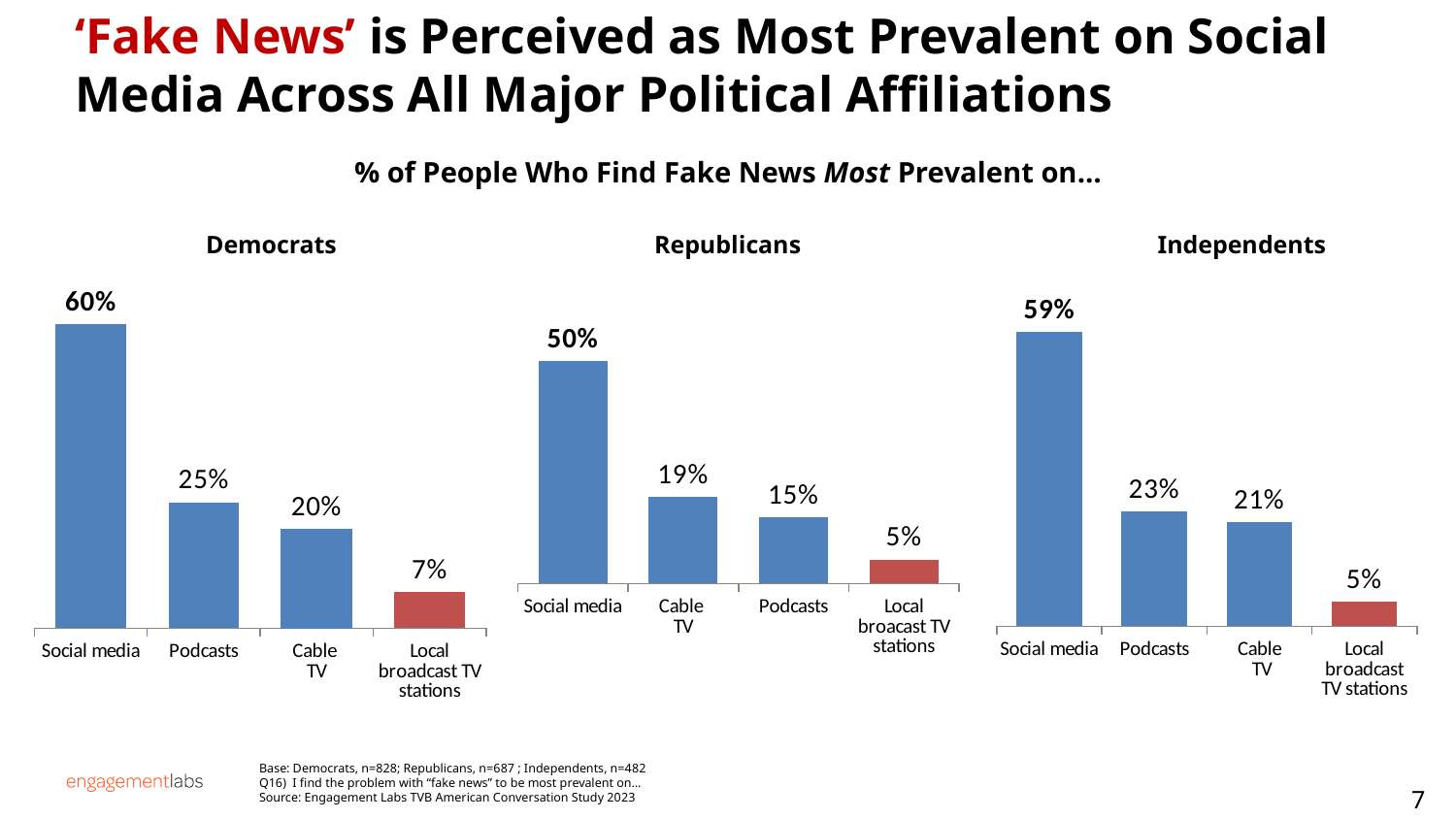
In the Independents chart, what is the difference between Podcasts and Local broadcast TV stations? 18% In the Republicans chart, which is larger, Cable TV or Podcasts? Cable TV In the Independents chart, what is the value for Cable TV? 21% How many categories are shown in the Democrats chart? 4 In the Republicans chart, what is the value for Podcasts? 15% In the Democrats chart, what is the difference between the Social media and Podcasts values? 35% In the Republicans chart, which bar is coloured red? Local broadcast TV stations What kind of chart is used for the Independents data? Bar chart In the Independents chart, which category has the lowest value? Local broadcast TV stations In the Democrats chart, what percentage of people find fake news most prevalent on Social media? 60% In the Republicans chart, which category has the highest value? Social media Which is larger: the Social media value in the Democrats chart or the Social media value in the Republicans chart? Democrats